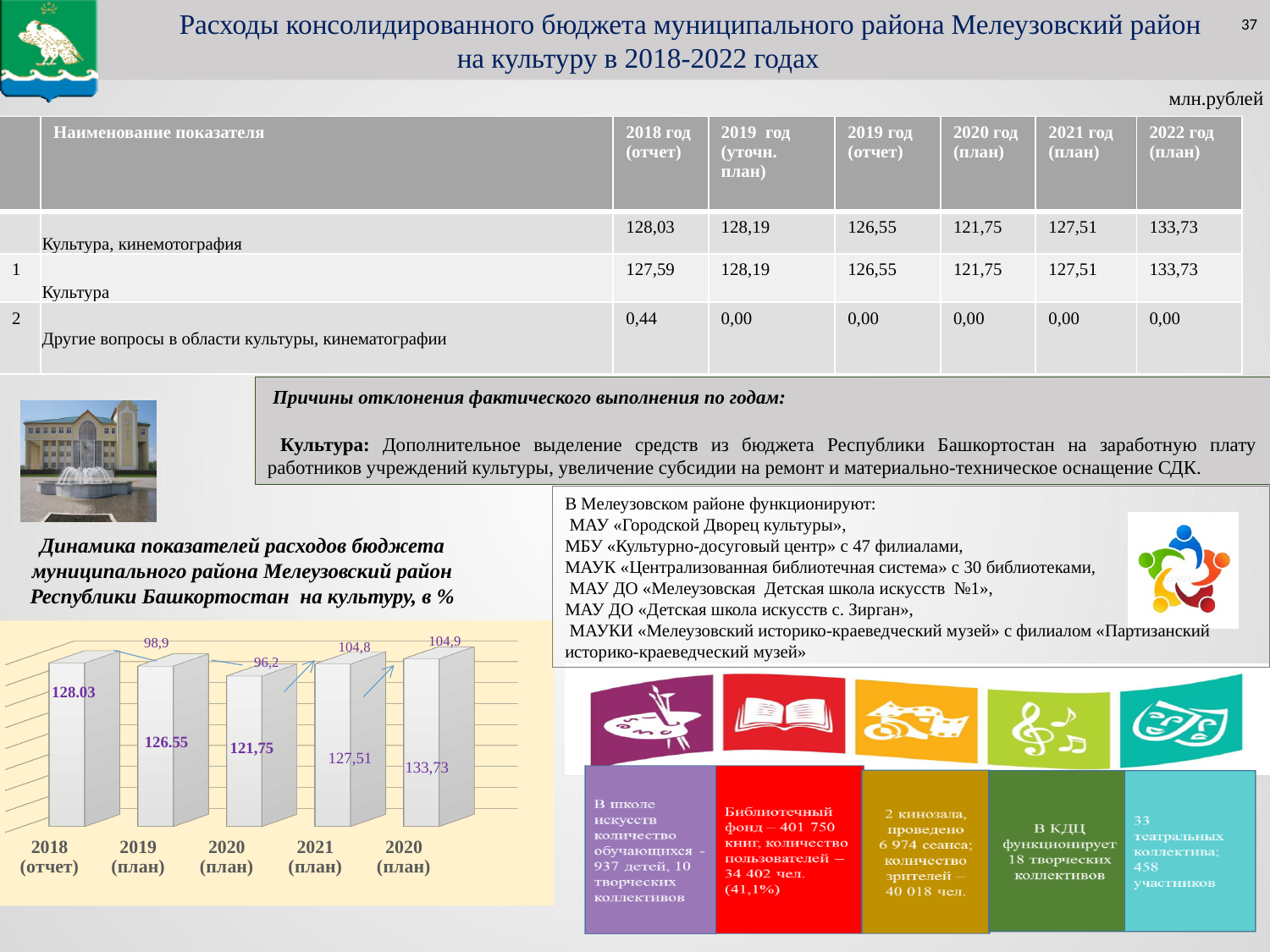
What is the highest value shown in the chart? 133,73 Do the values rise or fall from 2018 (отчет) to the third bar (121,75)? fall What kind of chart is shown on the slide? bar chart What is the difference between the value for 2021 (план) and the value of the bar labelled 121,75? 5,76 What is the value for 2018 (отчет) in the chart? 128.03 What is the value of the rightmost bar in the chart? 133,73 Which is larger, the value for 2018 (отчет) or the value for 2021 (план)? 2018 (отчет) What is the value for 2019 (план) in the chart? 126.55 What is the value for 2021 (план) in the chart? 127,51 What is the lowest value shown in the chart? 121,75 What percentage label is shown above the 2019 (план) bar? 98,9 How many bars does the chart show? 5